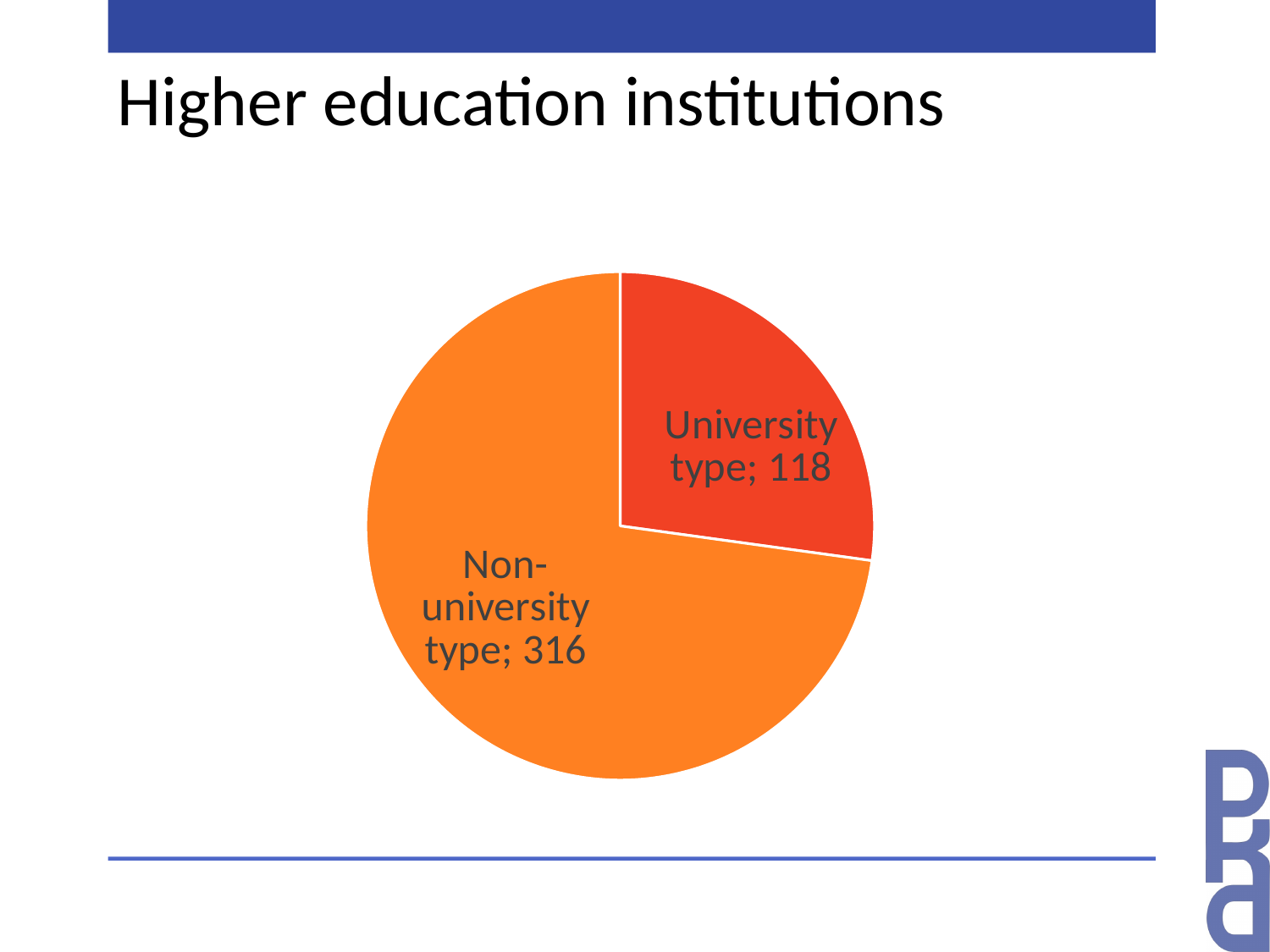
Which slice of the pie chart is the largest? Non-university type What share of the pie does University type represent, to one decimal place? 27.2% What is the value for Non-university type in the pie chart? 316 What is the value for University type in the pie chart? 118 What is the title of the slide containing the pie chart? Higher education institutions What kind of chart is shown on the slide? Pie chart How many slices does the pie chart have? 2 Which slice of the pie chart is the smallest? University type Which is larger, University type or Non-university type? Non-university type What share of the pie does Non-university type represent, to one decimal place? 72.8% What is the difference between the Non-university type and University type values? 198 What is the total of all slices in the pie chart? 434